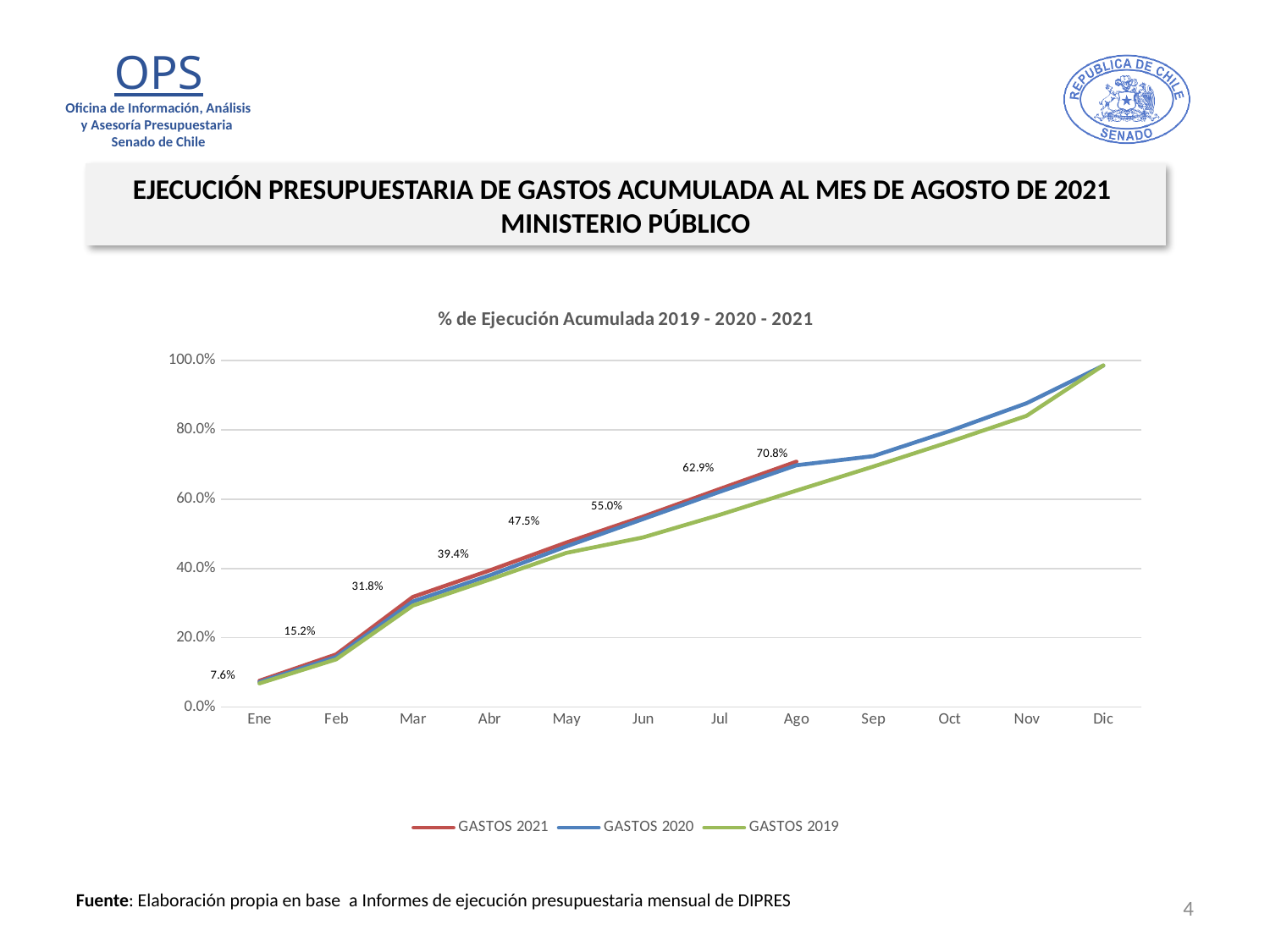
Is the value for GASTOS 2019 in Oct greater or less than 80.0%? less What is the value of GASTOS 2021 in Jun? 55.0% How many series does the legend list? 3 What is the value of GASTOS 2021 in Mar? 31.8% What is the value of GASTOS 2021 in Ene? 7.6% By how many percentage points did GASTOS 2021 increase from Ene to Feb? 7.6 percentage points Do the values of GASTOS 2020 rise or fall from Ene to Dic? Rise What kind of chart is shown? Line chart By how many percentage points did GASTOS 2021 increase from Jul to Ago? 7.9 percentage points What is the value of GASTOS 2021 in Ago? 70.8% In which month does GASTOS 2021 reach its highest labelled value? Ago How many months are shown on the x axis? 12